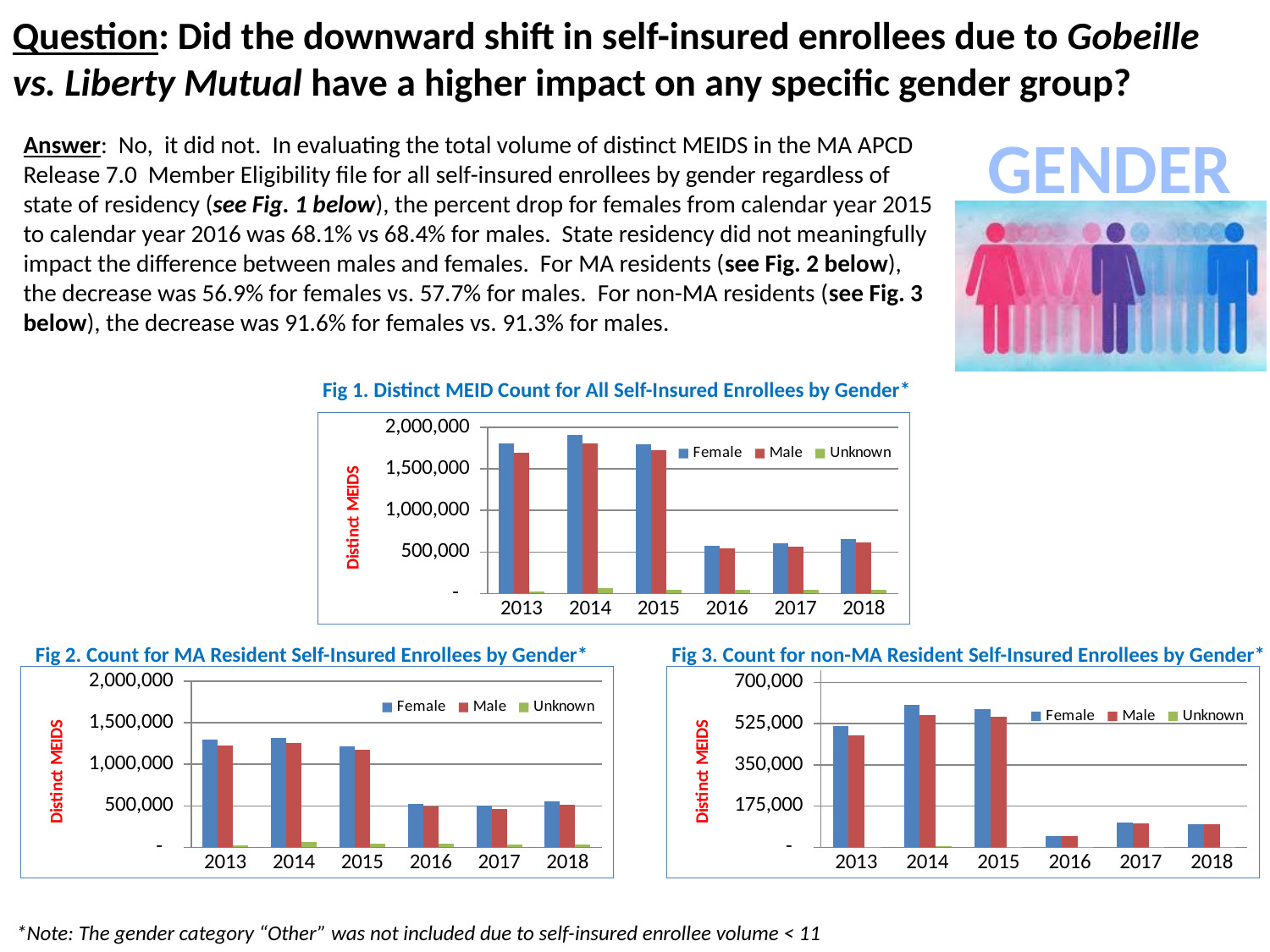
In Fig 3. Count for non-MA Resident Self-Insured Enrollees by Gender, do the Female values rise or fall from 2015 to 2016? fall What kind of chart is Fig 1. Distinct MEID Count for All Self-Insured Enrollees by Gender? bar chart In Fig 1. Distinct MEID Count for All Self-Insured Enrollees by Gender, is the Male value for 2016 greater or less than 1,000,000? less In Fig 1. Distinct MEID Count for All Self-Insured Enrollees by Gender, how many years are shown on the x axis? 6 In Fig 1. Distinct MEID Count for All Self-Insured Enrollees by Gender, how many series does the legend list? 3 In Fig 3. Count for non-MA Resident Self-Insured Enrollees by Gender, which year has the lowest Female value? 2016 In Fig 3. Count for non-MA Resident Self-Insured Enrollees by Gender, is the Female value for 2014 greater or less than 525,000? greater In Fig 1. Distinct MEID Count for All Self-Insured Enrollees by Gender, which year has the lowest Female value? 2016 In Fig 2. Count for MA Resident Self-Insured Enrollees by Gender, which is larger in 2013, the Female value or the Male value? Female In Fig 2. Count for MA Resident Self-Insured Enrollees by Gender, is the Female value for 2013 greater or less than 1,000,000? greater In Fig 1. Distinct MEID Count for All Self-Insured Enrollees by Gender, which year has the highest Female value? 2014